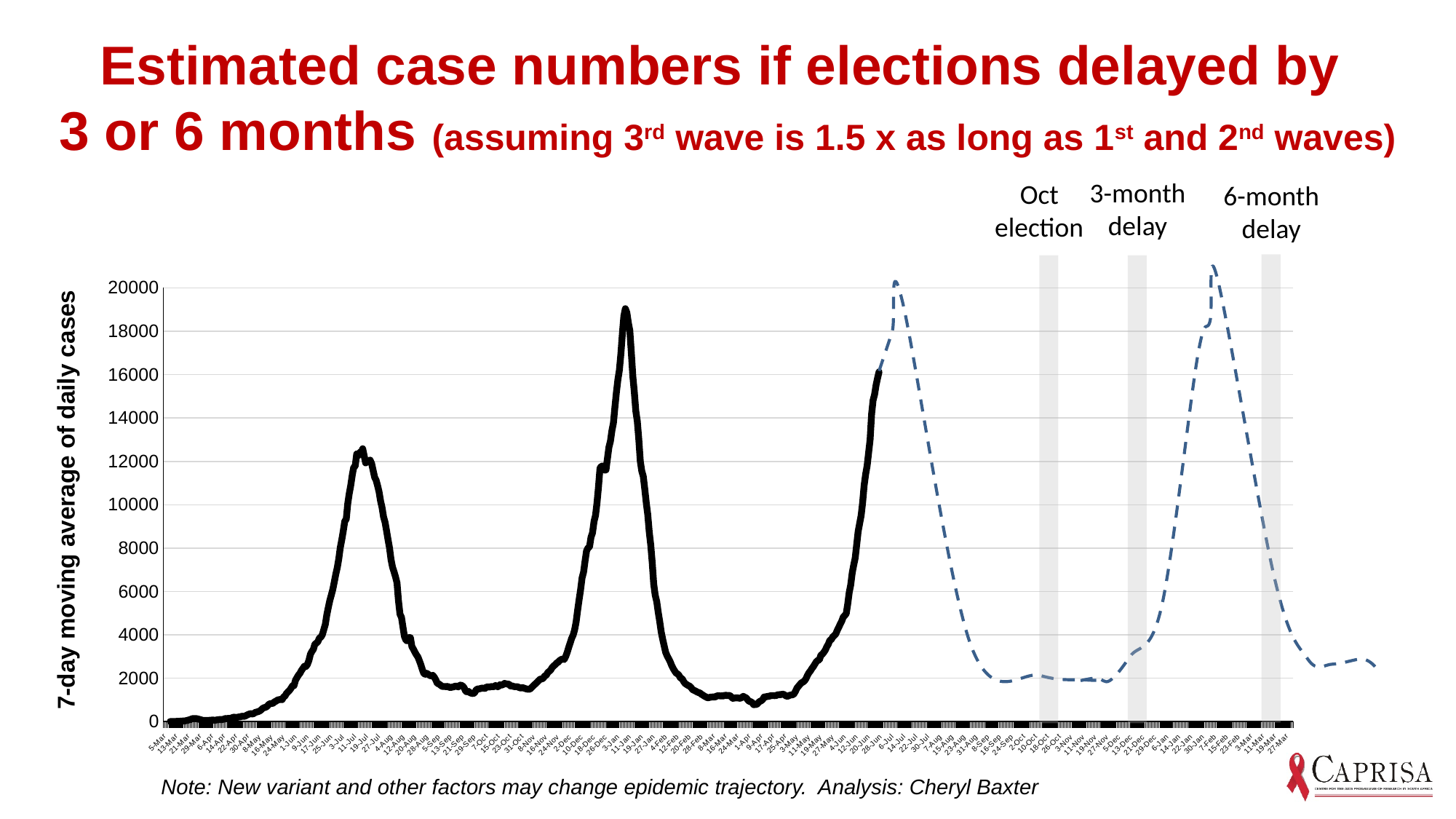
Which peak is higher, the first wave in July 2020 or the second wave in January 2021? second wave in January 2021 Is the projected peak of the third wave (dashed line, around July 2021) greater or less than 18000? greater Is the peak of the first wave (around July 2020) greater or less than 10000? greater Is the projected value at the 3-month delay band greater or less than 6000? less What are the three labels above the shaded vertical bands on the chart? Oct election, 3-month delay, 6-month delay Between the second-wave peak in January 2021 and April 2021, does the line rise or fall? fall What is the label on the y axis of the chart? 7-day moving average of daily cases What type of chart is shown on the slide? line chart